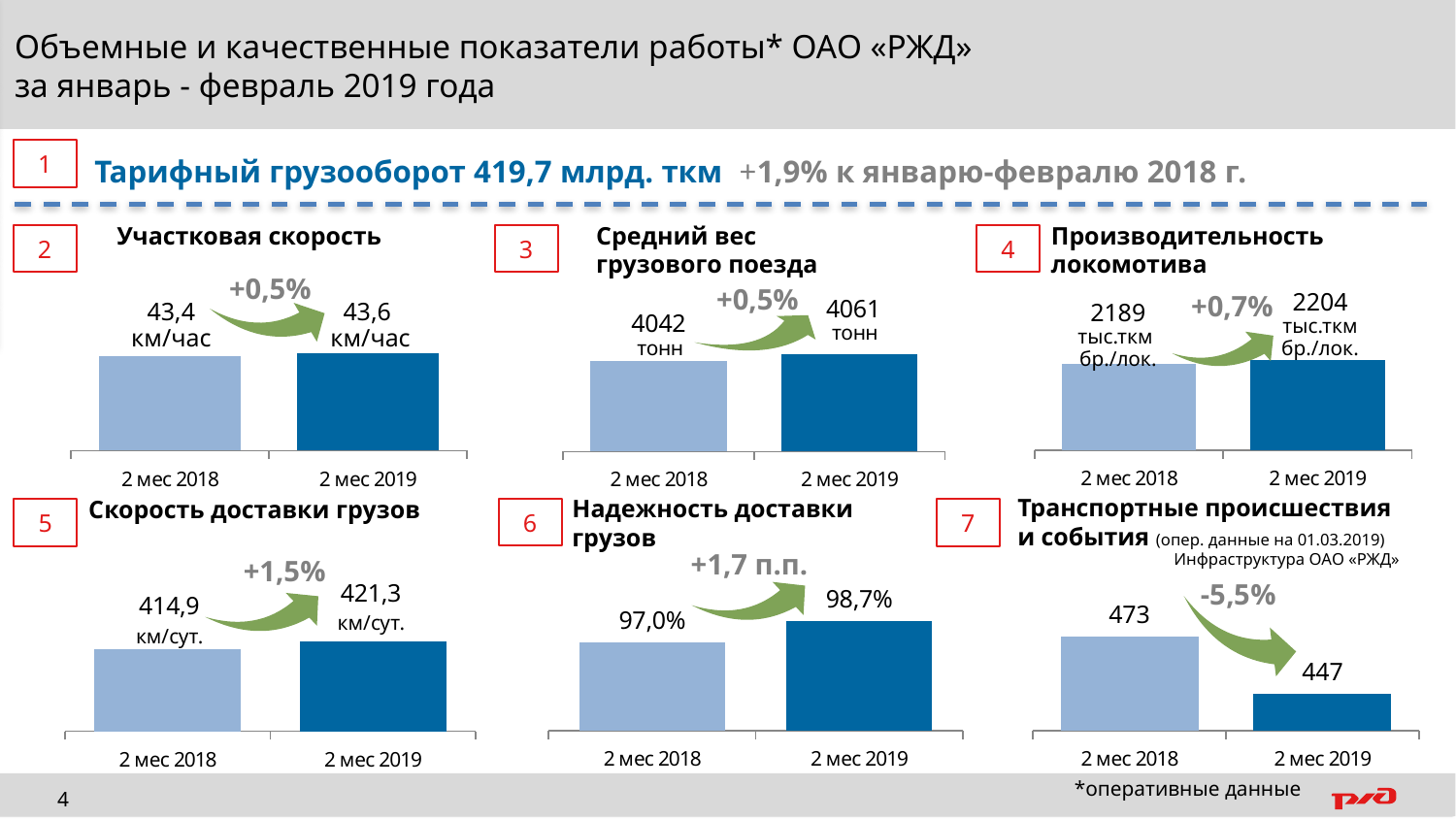
In the chart "Надежность доставки грузов", what is the value for 2 мес 2019? 98,7% What kind of chart is "Производительность локомотива"? bar chart In the chart "Надежность доставки грузов", do the values rise or fall from 2 мес 2018 to 2 мес 2019? rise In the chart "Транспортные происшествия и события", which period has the lower value? 2 мес 2019 In the chart "Участковая скорость", what is the value for 2 мес 2019? 43,6 км/час In the chart "Средний вес грузового поезда", which is larger: the value for 2 мес 2018 or for 2 мес 2019? 2 мес 2019 In the chart "Производительность локомотива", what is the value for 2 мес 2019? 2204 тыс.ткм бр./лок. In the chart "Скорость доставки грузов", what is the difference between the 2 мес 2019 and 2 мес 2018 values? 6,4 км/сут. In the chart "Транспортные происшествия и события", what is the difference between the 2 мес 2018 and 2 мес 2019 values? 26 How many categories are shown in the chart "Скорость доставки грузов"? 2 What percentage change is shown above the chart "Транспортные происшествия и события"? -5,5% In the chart "Средний вес грузового поезда", what is the value for 2 мес 2018? 4042 тонн